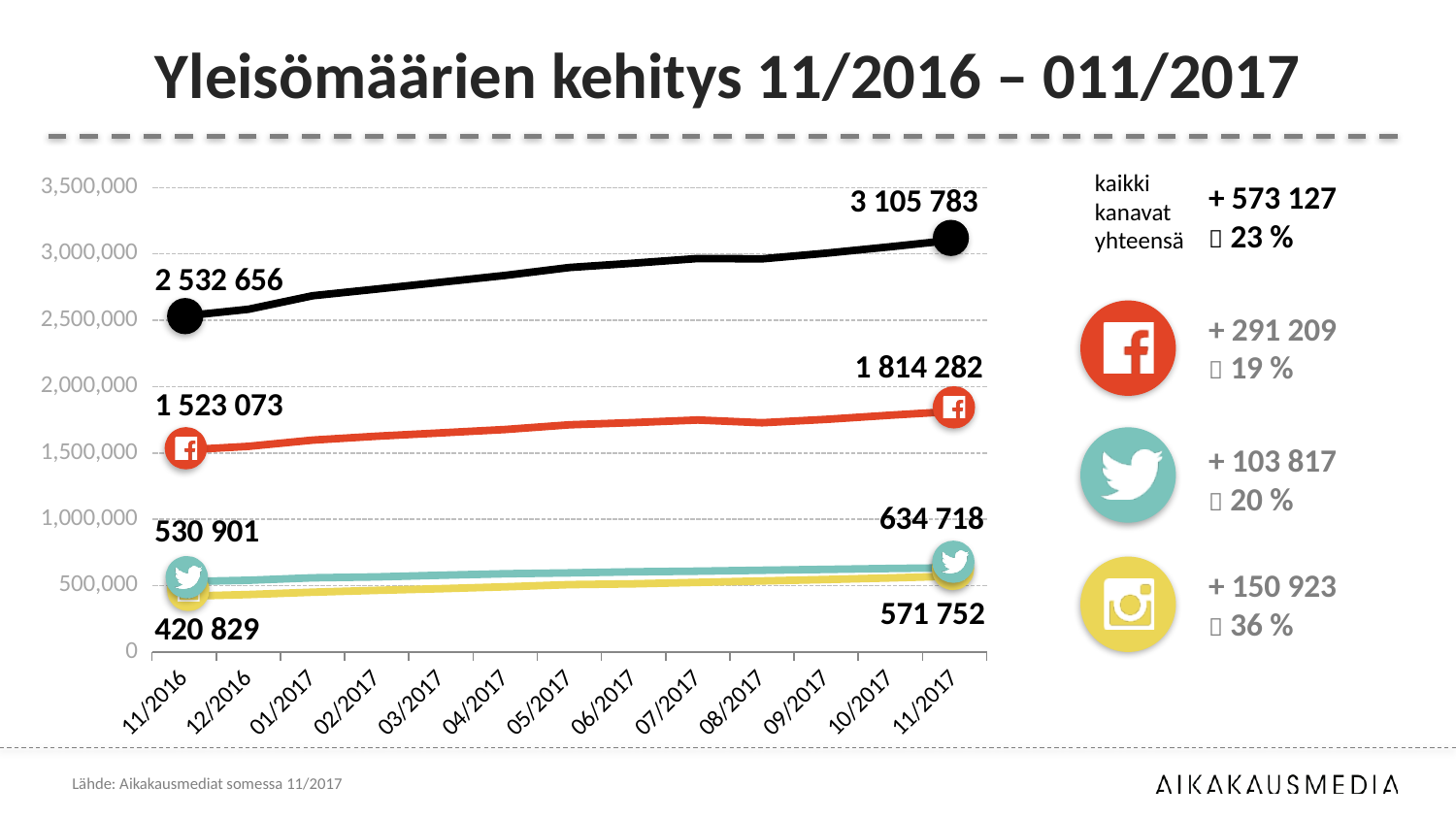
What is the Instagram value at 11/2017? 571 752 What is the Twitter value at 11/2016? 530 901 What type of chart is shown on the slide? line chart Does the black (total) line rise or fall from 11/2016 to 11/2017? rise By how much did the total (black line) grow from 11/2016 to 11/2017? 573 127 How many months are shown on the x axis? 13 Is the Facebook value at 11/2017 greater or less than 2,000,000? less Which is larger at 11/2017: the Twitter value or the Instagram value? Twitter What is the value of the black (total) line at 11/2016? 2 532 656 What is the Facebook value at 11/2017? 1 814 282 By how much did the Facebook value grow from 11/2016 to 11/2017? 291 209 What is the value of the black (total) line at 11/2017? 3 105 783